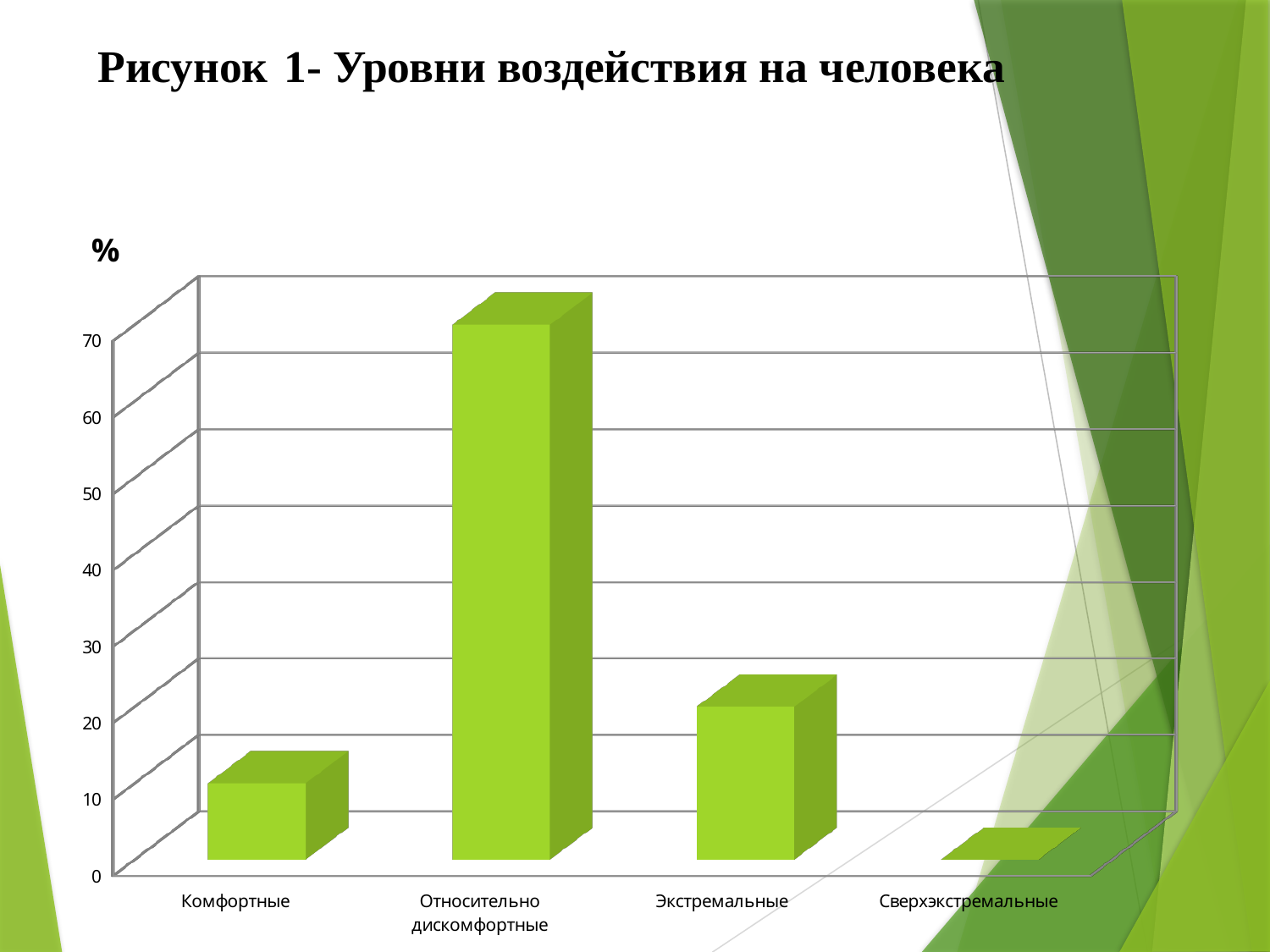
What unit is shown on the vertical axis of the chart? % What kind of chart is shown on the slide? bar chart Is the value for Относительно дискомфортные greater or less than 60? greater Which is larger, the value for Относительно дискомфортные or the value for Экстремальные? Относительно дискомфортные Is the value for Экстремальные greater or less than 30? less Which is larger, the value for Экстремальные or the value for Комфортные? Экстремальные How many categories are shown on the x axis of the chart? 4 Is the value for Сверхэкстремальные greater or less than 10? less What is the title of the chart on the slide? Рисунок 1- Уровни воздействия на человека Which category has the lowest value in the chart? Сверхэкстремальные Which category has the highest value in the chart? Относительно дискомфортные